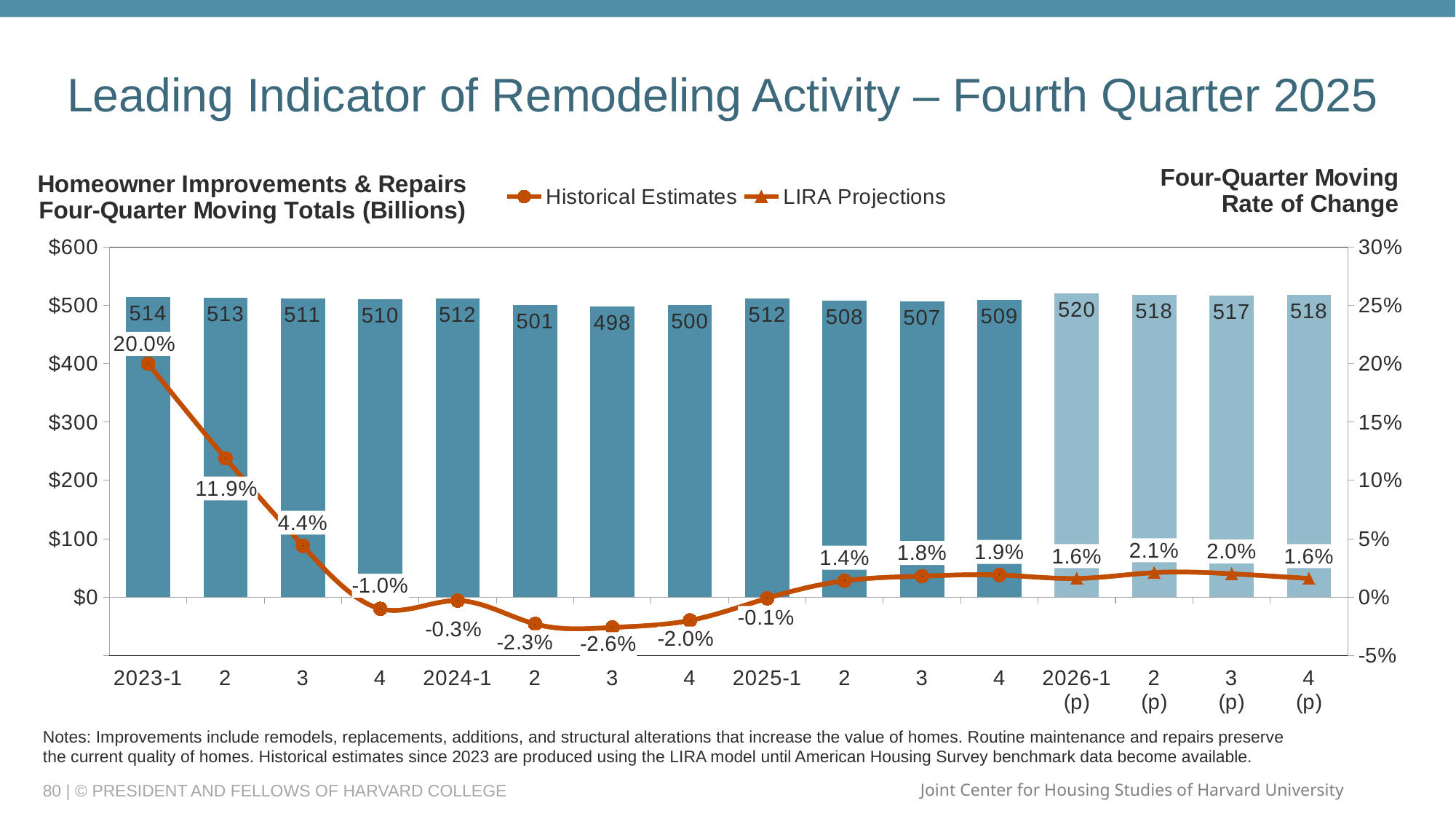
Which quarter has the lowest four-quarter moving total? 2024-3 Which quarter has the highest four-quarter moving total? 2026-1 (p) How many series does the legend list? 2 What is the difference between the highest four-quarter moving total (2026-1 (p)) and the lowest (2024-3)? 22 What is the four-quarter moving total of homeowner improvements and repairs for 2023-1? 514 How many quarters are plotted on the x axis? 16 What is the LIRA projected rate of change for 2026-2 (p)? 2.1% What is the projected four-quarter moving total for 2026-1 (p)? 520 Is the four-quarter moving total for 2025-2 larger or smaller than the total for 2025-4? smaller Does the rate of change line rise or fall from 2023-1 to 2023-4? fall What is the four-quarter moving rate of change shown for 2024-3? -2.6% Which quarter has the highest four-quarter moving rate of change? 2023-1